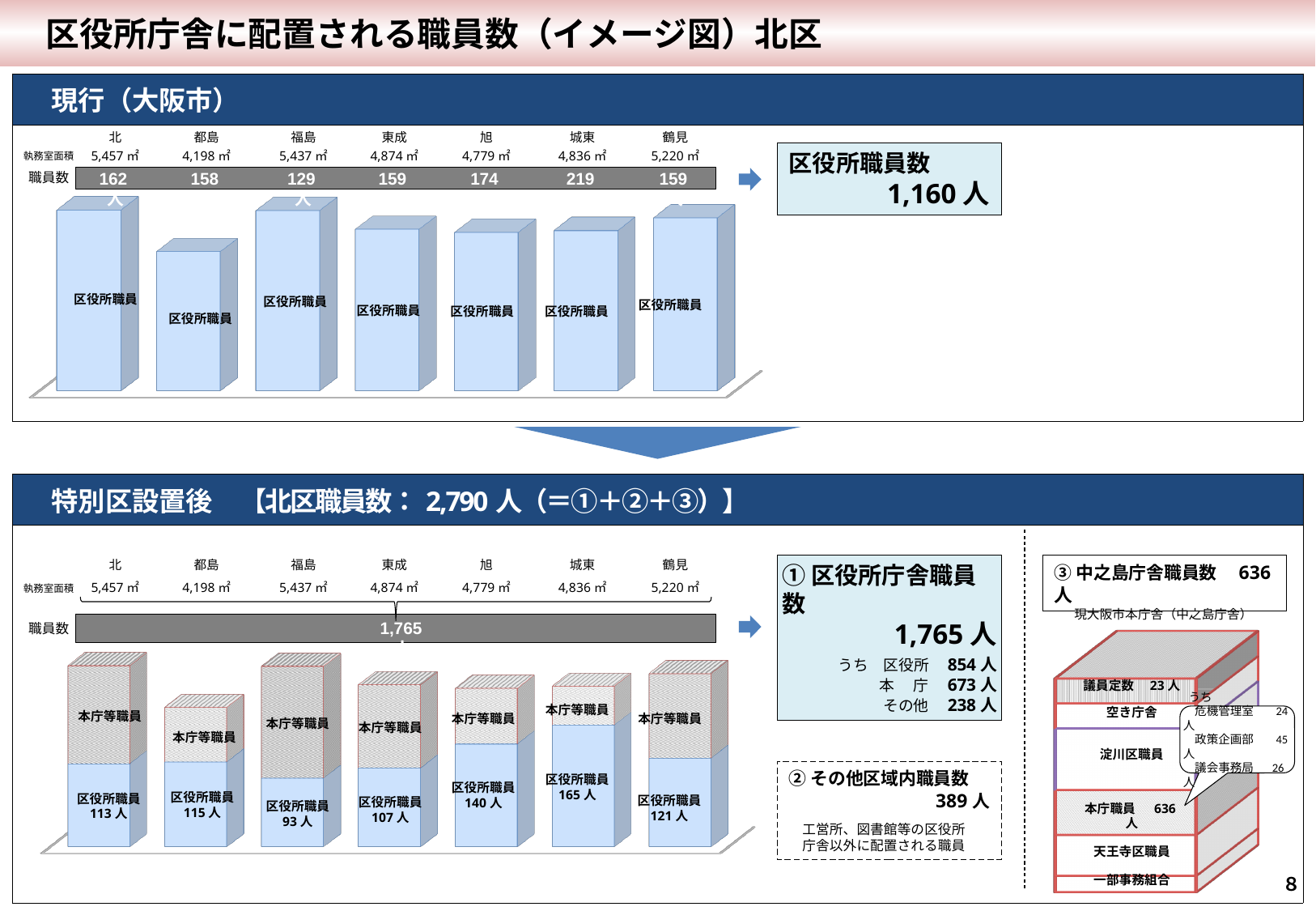
In the top chart (現行（大阪市）), what is the total 区役所職員数 shown in the box on the right? 1,160 人 In the top chart (現行（大阪市）), what is the 職員数 value for 北? 162 In the bottom chart (特別区設置後), which ward has the highest 区役所職員 value? 城東 In the bottom chart (特別区設置後), which ward has the lowest 区役所職員 value? 福島 In the top chart (現行（大阪市）), which has a larger 職員数, 旭 or 北? 旭 In the top chart (現行（大阪市）), what is the difference in 職員数 between 城東 and 福島? 90 What kind of chart is used in the top section (現行（大阪市）)? bar chart In the top chart (現行（大阪市）), which ward has the highest 職員数? 城東 In the top chart (現行（大阪市）), how many wards are shown? 7 In the bottom chart (特別区設置後), what is the 区役所職員 value for 東成? 107 人 In the top chart (現行（大阪市）), which ward has the lowest 職員数? 福島 In the bottom chart (特別区設置後), what is the difference in 区役所職員 between 城東 and 福島? 72 人